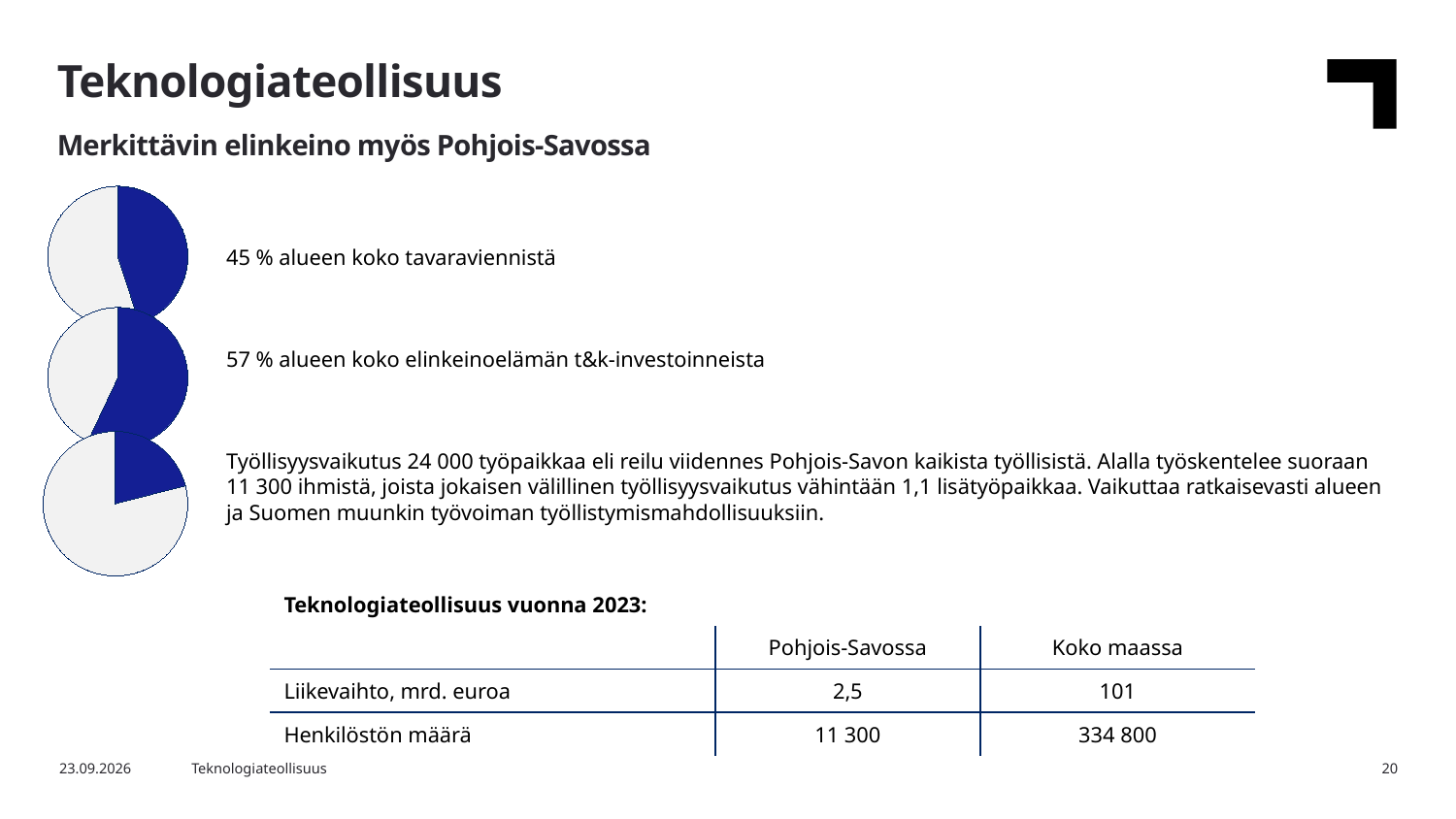
How many slices does each pie chart on the slide have? 2 How many pie charts are on the slide? 3 In the middle pie chart, what share of the region's business R&D investments (t&k-investoinnit) does the blue slice represent? 57 % Which of the three pie charts has the smallest blue slice? The bottom one What colour is used for the highlighted slice in the pie charts? Blue In the top pie chart, what share of the region's total goods exports (tavaravienti) does the blue slice represent? 45 % What is the difference in percentage points between the blue shares of the middle and top pie charts? 12 percentage points Is the blue share in the bottom pie chart greater or less than 50 %? less Which of the three pie charts has the largest blue slice? The middle one Is the blue share in the middle pie chart greater or less than 50 %? greater Which pie chart has the larger blue slice, the top one or the middle one? The middle one What kind of charts are shown on the left side of the slide? Pie charts